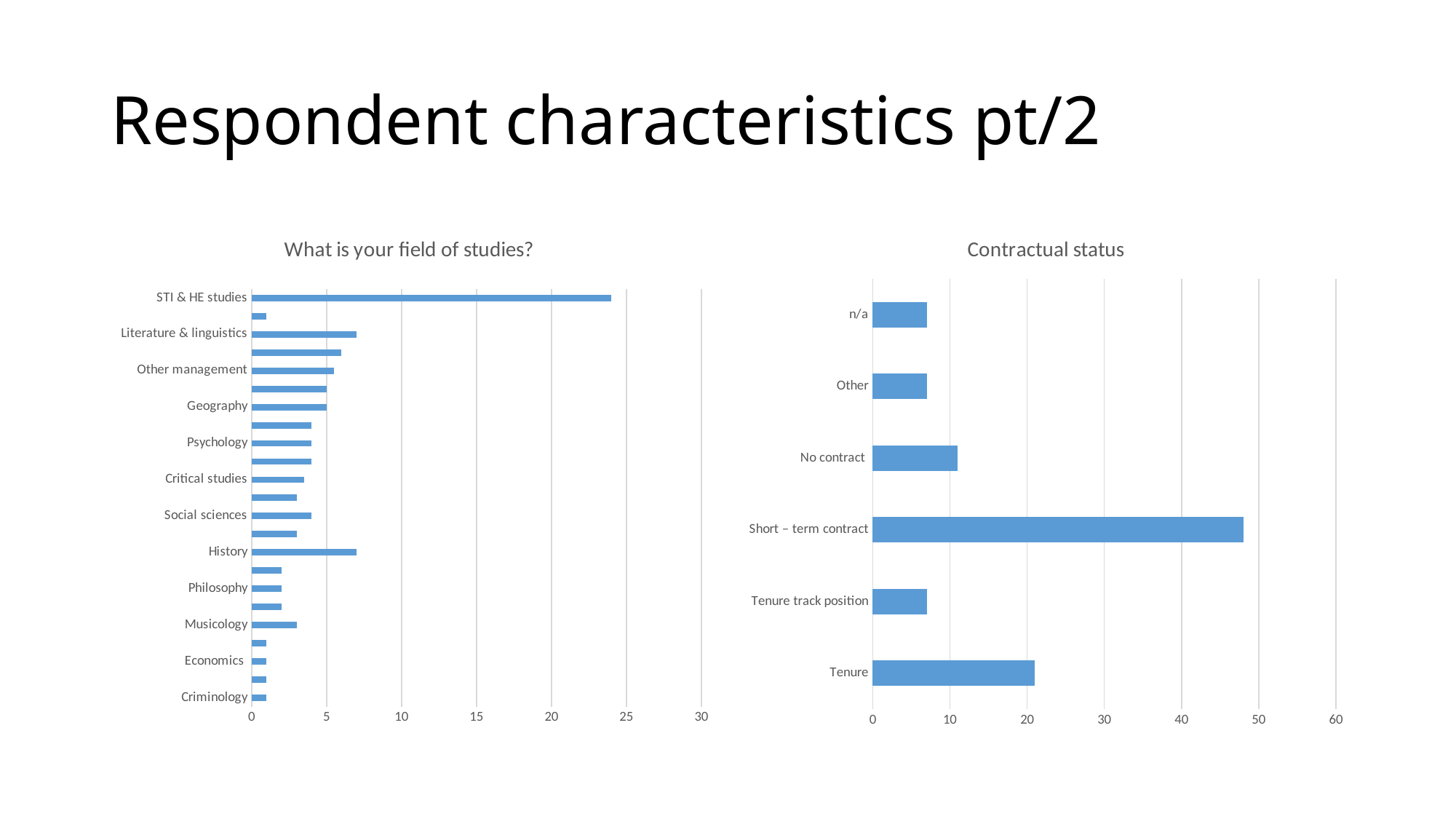
In the 'Contractual status' chart, is the value for Short – term contract greater or less than 40? greater In the 'Contractual status' chart, which is larger: Tenure or No contract? Tenure In the 'Contractual status' chart, which category has the highest value? Short – term contract What kind of chart is the 'Contractual status' chart? bar chart In the 'What is your field of studies?' chart, is the value for History greater or less than 10? less In the 'Contractual status' chart, is the value for Tenure greater or less than 30? less In the 'What is your field of studies?' chart, which category has the highest value? STI & HE studies What is the title of the chart on the left side of the slide? What is your field of studies? How many categories are shown in the 'Contractual status' chart? 6 In the 'What is your field of studies?' chart, which is larger: History or Philosophy? History